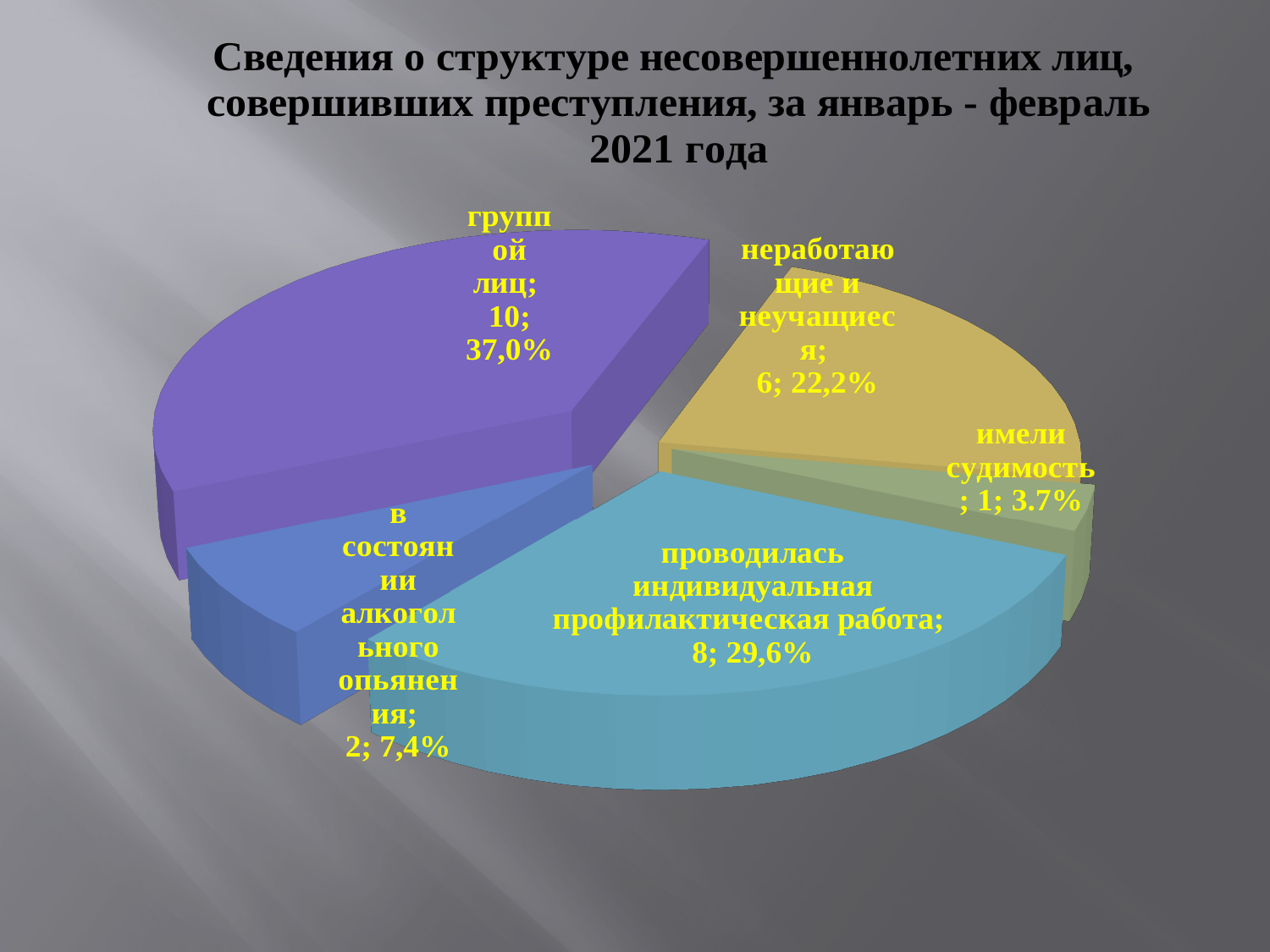
What share of the pie does "проводилась индивидуальная профилактическая работа" represent? 29,6% What share of the pie does "группой лиц" represent? 37,0% What colour is the slice for "проводилась индивидуальная профилактическая работа"? teal (light blue) What is the value for "группой лиц"? 10 What kind of chart is shown on the slide? pie chart What is the difference between the values for "группой лиц" and "проводилась индивидуальная профилактическая работа"? 2 How many slices does the pie chart have? 5 Which category has the smallest slice? имели судимость What is the value for "неработающие и неучащиеся"? 6 What is the value for "в состоянии алкогольного опьянения"? 2 Which category has the largest slice? группой лиц Which is larger, the value for "неработающие и неучащиеся" or the value for "в состоянии алкогольного опьянения"? неработающие и неучащиеся